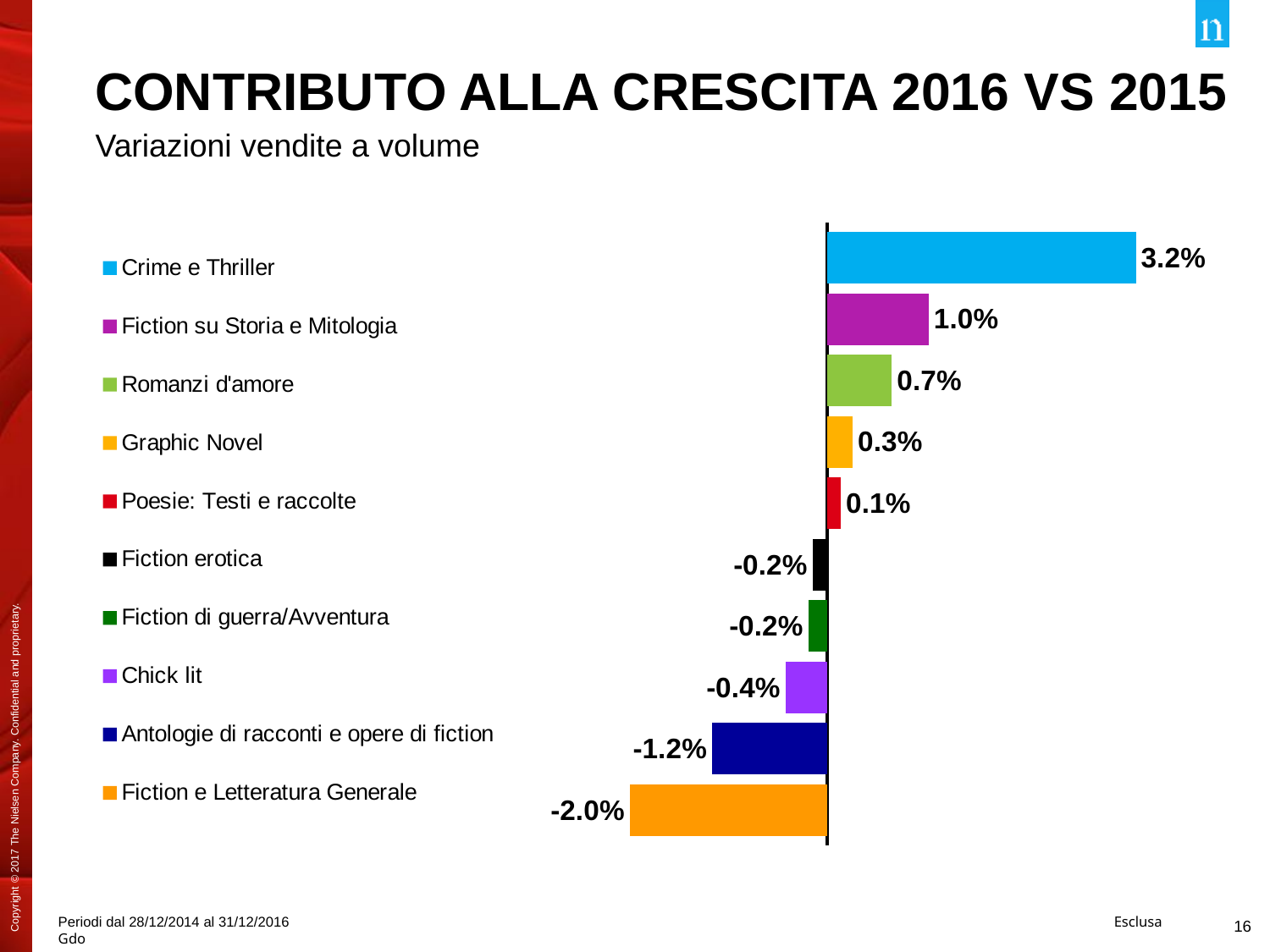
What is the value for Romanzi d'amore? 0.7% How many categories are shown in the chart? 10 What is the value for Fiction e Letteratura Generale? -2.0% What is the value for Antologie di racconti e opere di fiction? -1.2% Which is larger, the value for Graphic Novel or the value for Poesie: Testi e raccolte? Graphic Novel What kind of chart is shown on the slide? Bar chart What is the title of the slide? CONTRIBUTO ALLA CRESCITA 2016 VS 2015 What is the difference between the values for Crime e Thriller and Fiction su Storia e Mitologia? 2.2% Which category has the lowest value? Fiction e Letteratura Generale Which category has the highest value? Crime e Thriller How many categories have a negative value? 5 What is the value for Crime e Thriller? 3.2%